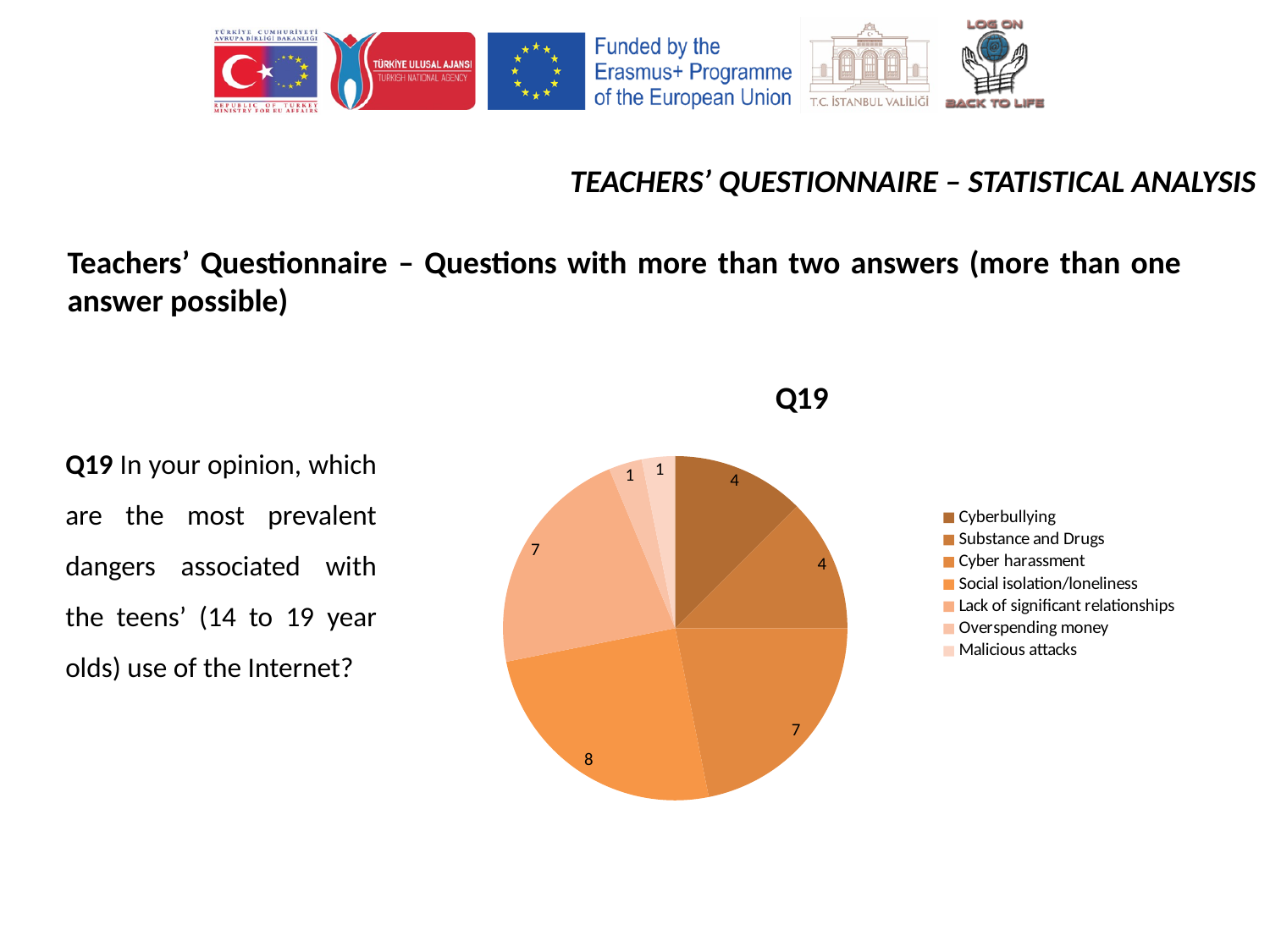
What share of the Q19 pie does Social isolation/loneliness represent? 25% What is the value for Cyberbullying in the Q19 pie chart? 4 What is the title of the chart? Q19 Which is larger in the Q19 pie chart, Lack of significant relationships or Substance and Drugs? Lack of significant relationships What is the value for Social isolation/loneliness in the Q19 pie chart? 8 What is the value for Cyber harassment in the Q19 pie chart? 7 How many categories does the legend of the Q19 pie chart list? 7 What type of chart is shown on the slide? Pie chart Which category has the largest slice in the Q19 pie chart? Social isolation/loneliness What is the value for Overspending money in the Q19 pie chart? 1 What is the total of all slice values in the Q19 pie chart? 32 What is the difference between the values for Social isolation/loneliness and Cyberbullying? 4